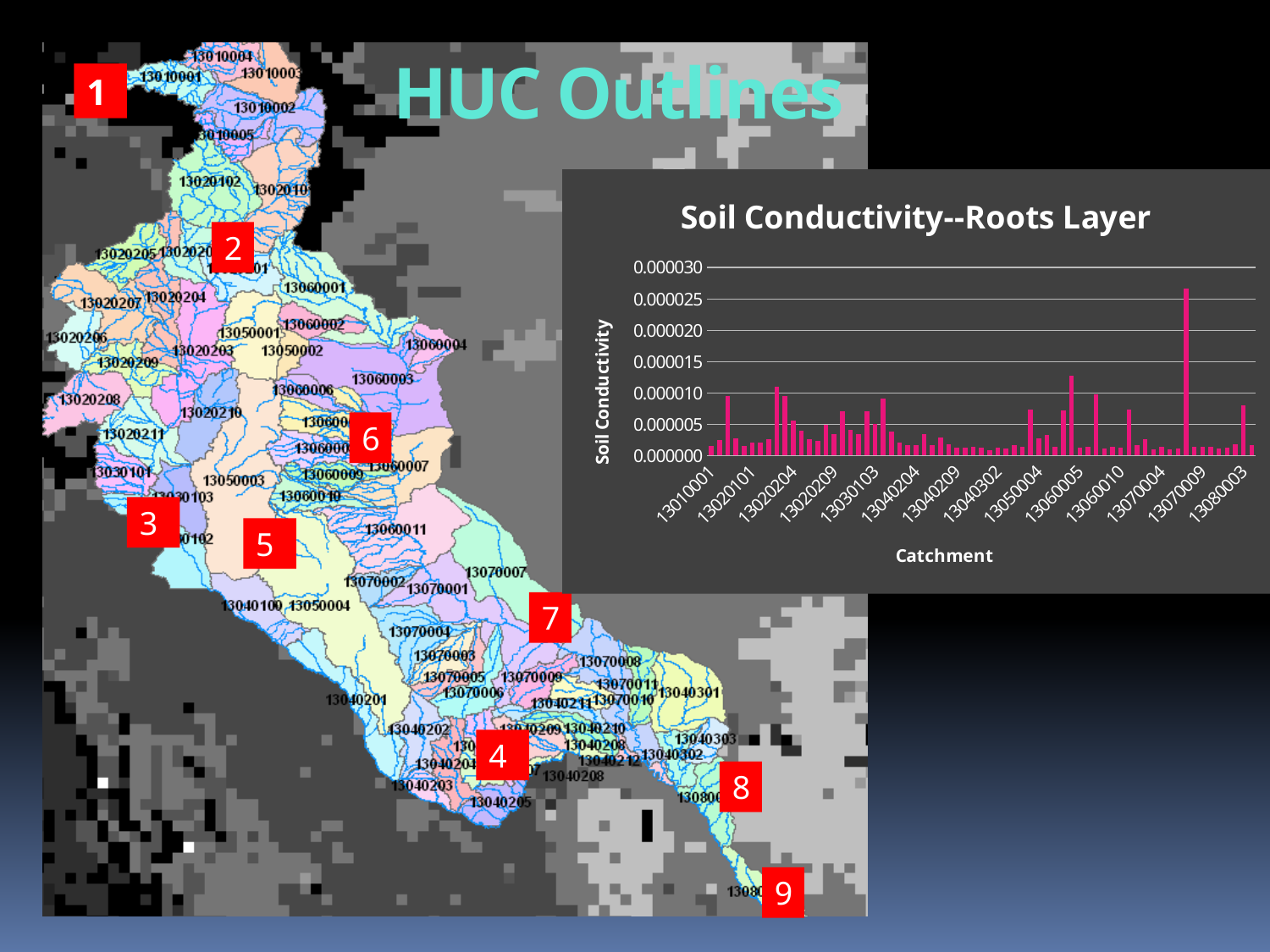
Is the tallest bar in the chart greater or less than 0.000030? less What is the title of the chart on the slide? Soil Conductivity--Roots Layer Is the tallest bar in the chart greater or less than 0.000020? greater What is the lowest value shown on the vertical axis of the chart? 0.000000 What kind of chart is shown on the slide? bar chart What is the highest value shown on the vertical axis of the chart? 0.000030 Is the value for catchment 13010001 greater or less than 0.000005? less What is the label of the horizontal axis of the chart? Catchment